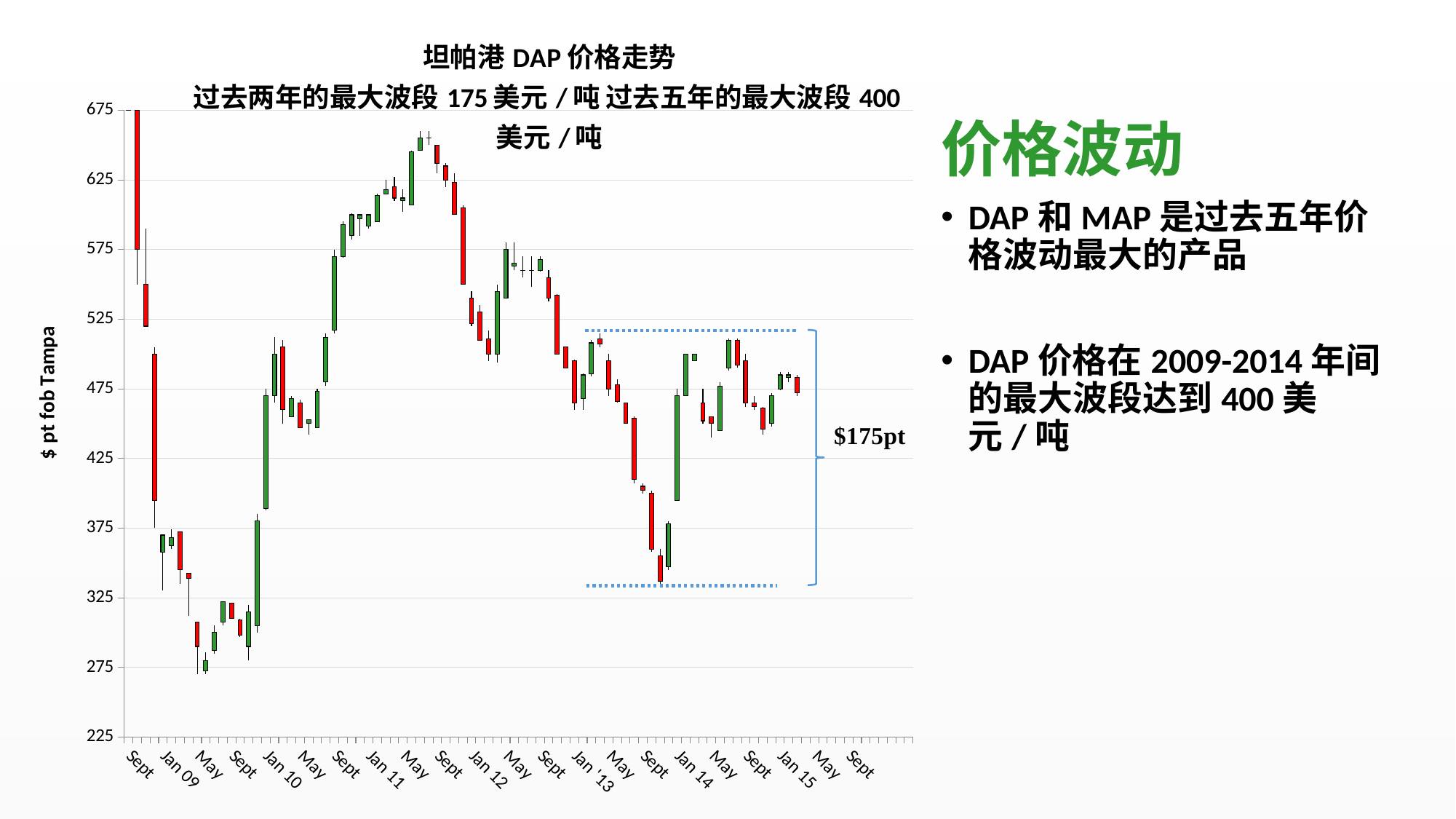
Is the DAP price at its low around Sept 2013 greater or less than 375? less What is the highest value shown on the vertical axis? 675 Which is higher, the DAP price around May 2011 or the DAP price around May 2009? May 2011 According to the chart subtitle, what was the largest price swing over the past five years? 400 美元/吨 Does the DAP price rise or fall between May 11 and Sept 13? fall Is the DAP price around May 2009 greater or less than 325? less What kind of chart is shown on the slide? Candlestick chart Is the DAP price at its peak around May 2011 greater or less than 625? greater What is the label on the vertical axis of the chart? $ pt fob Tampa What is the title of the chart? 坦帕港 DAP 价格走势 Does the DAP price rise or fall between Jan 10 and May 11? rise What value does the bracket annotation on the right side of the chart show? $175pt